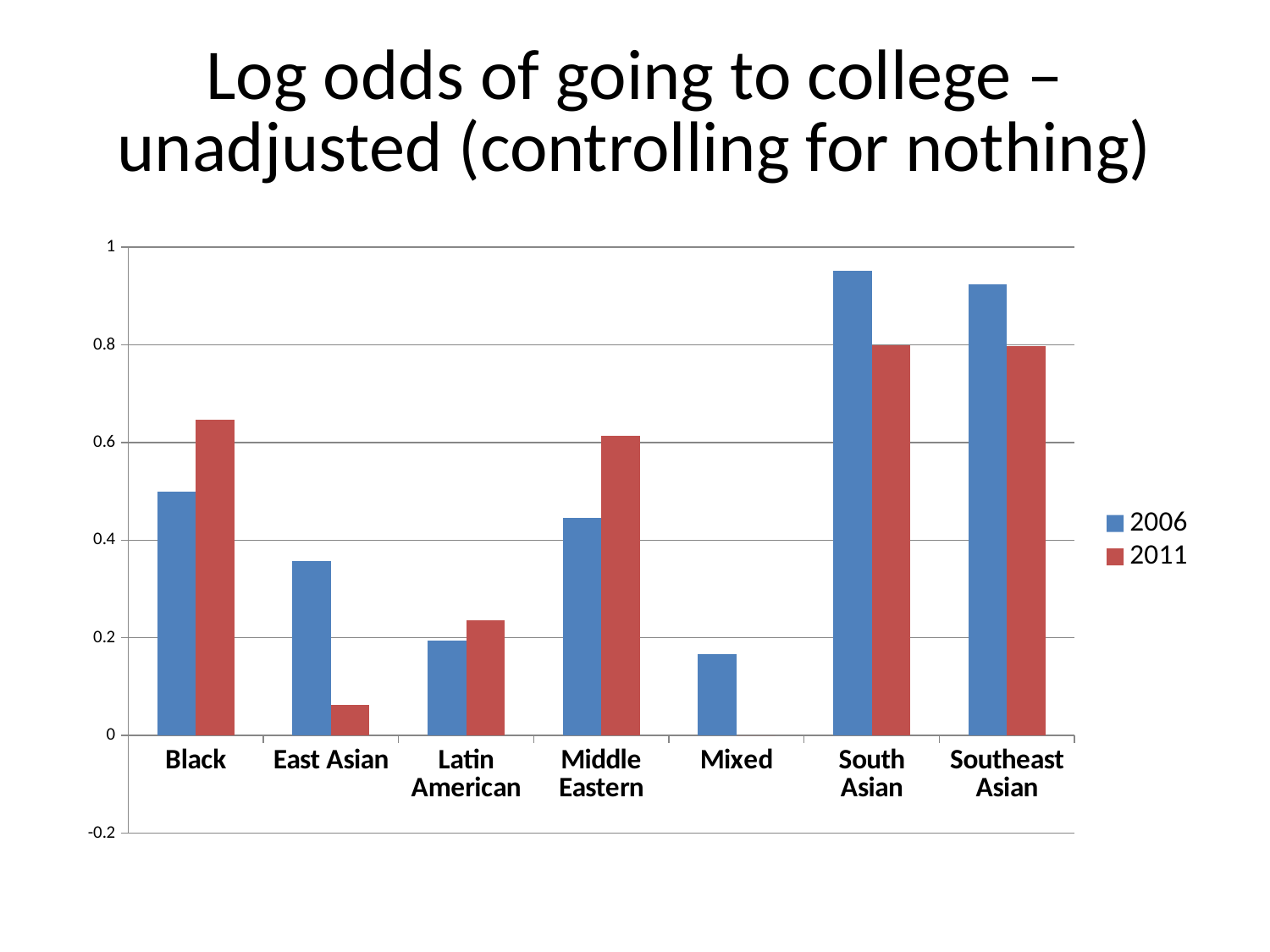
Is the 2006 value for South Asian greater or less than 0.8? greater How many series does the legend list? 2 Is the 2011 value for East Asian greater or less than 0.2? less Which category has the highest value for 2006? South Asian How many categories are shown on the x axis? 7 For Middle Eastern, which year has the larger value, 2006 or 2011? 2011 Which series are listed in the legend? 2006 and 2011 Is the 2006 value for Mixed greater or less than 0.2? less For Black, which year has the larger value, 2006 or 2011? 2011 For East Asian, which year has the larger value, 2006 or 2011? 2006 What kind of chart is shown on the slide? bar chart